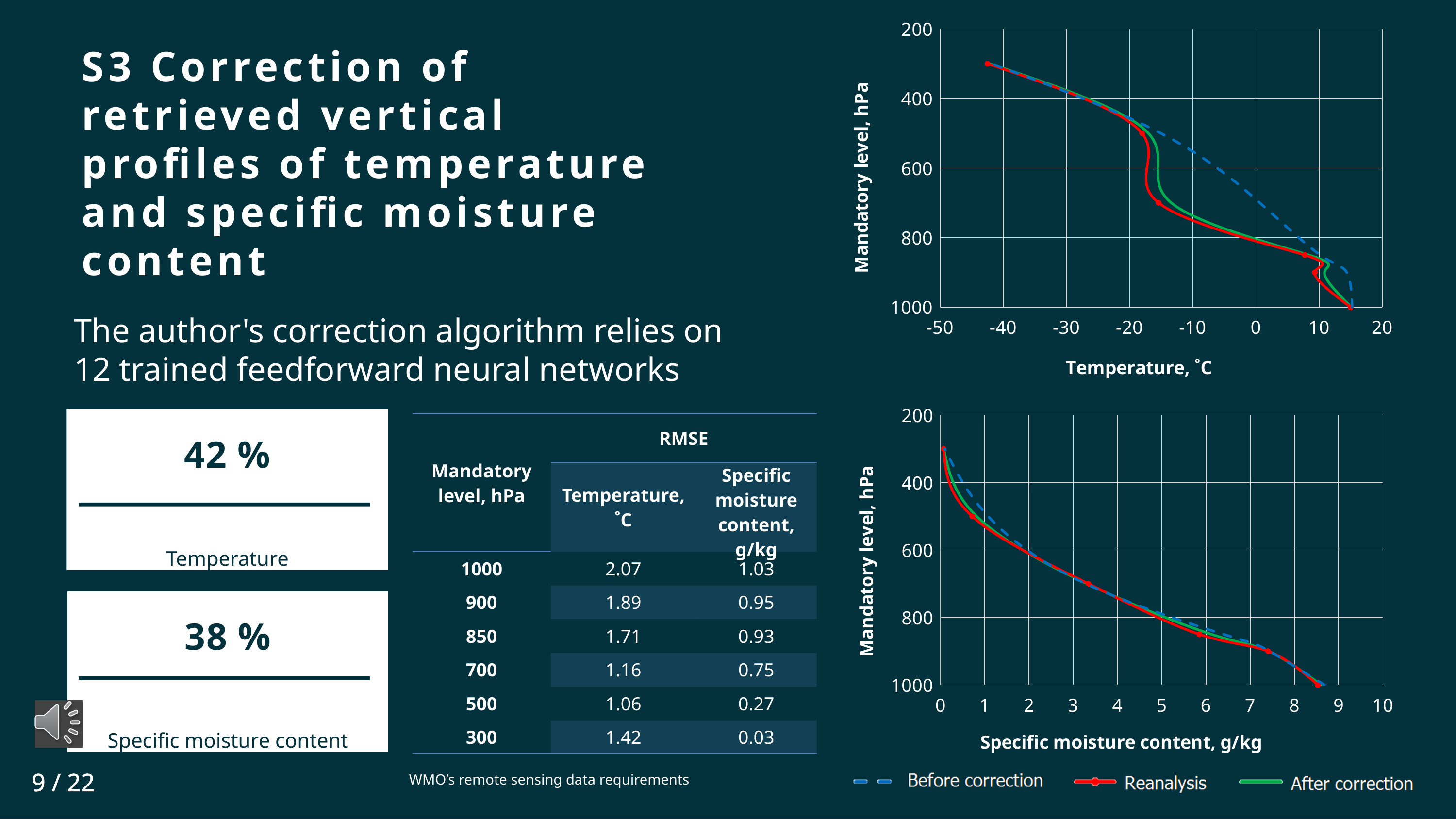
In the top-right temperature chart, is the Reanalysis temperature at the 1000 hPa level greater or less than 10? greater In the bottom-right specific moisture content chart, is the Reanalysis value at the 1000 hPa level greater or less than 8? greater What is the label of the y axis on the top-right chart? Mandatory level, hPa In the bottom-right specific moisture content chart, is the Reanalysis value at the 700 hPa level greater or less than 4? less What kind of chart is the top-right chart with the x axis 'Temperature, °C'? line chart How many series does the legend at the bottom of the slide list for the charts? 3 What is the highest value shown on the x axis of the bottom-right chart? 10 In the bottom-right chart, does specific moisture content rise or fall as the mandatory level increases from 200 hPa to 1000 hPa? rise In the top-right temperature chart, at the 600 hPa level, which series shows the higher temperature: Before correction or Reanalysis? Before correction